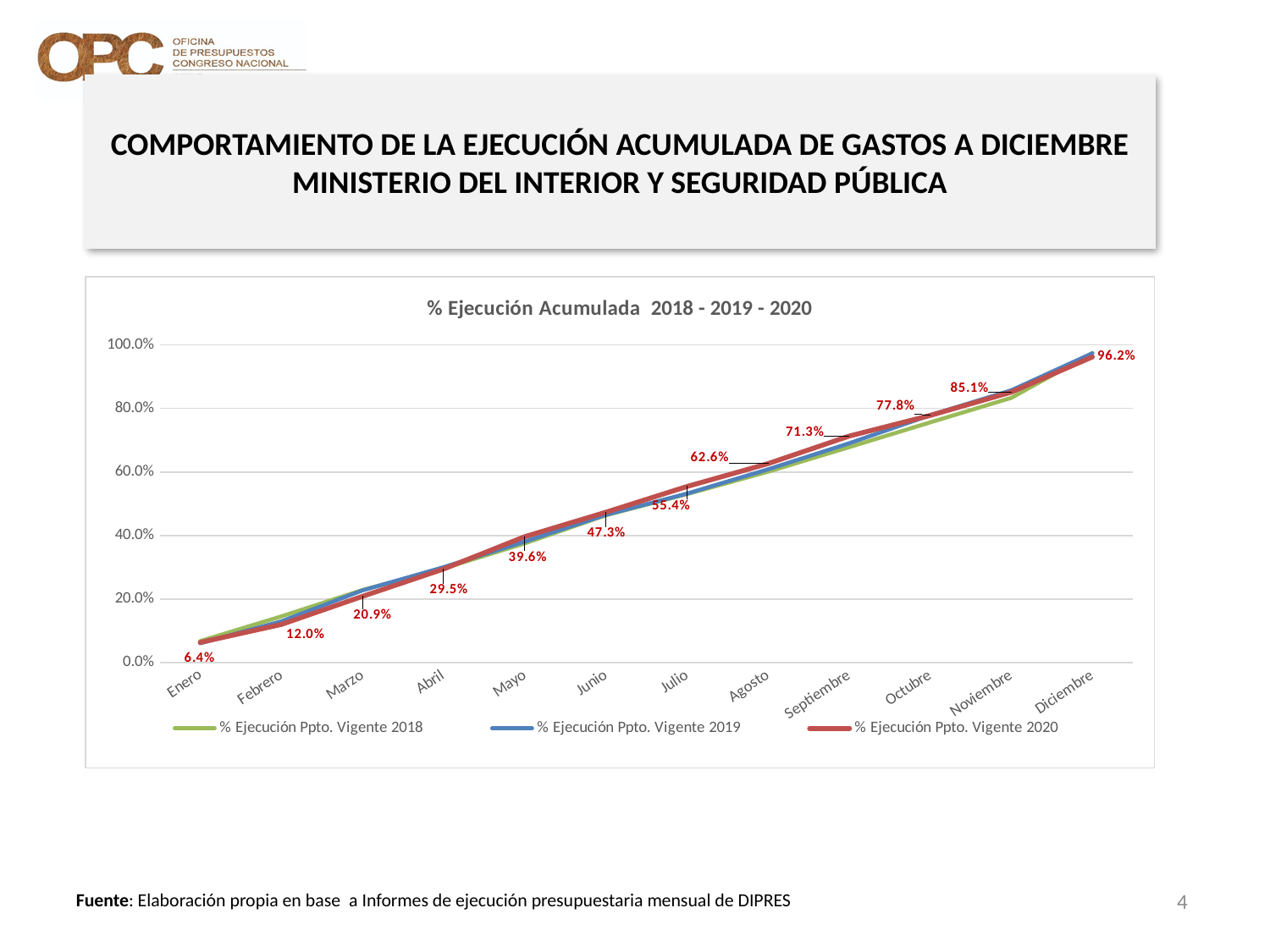
Which month has the highest value in the % Ejecución Ppto. Vigente 2020 series? Diciembre Is the value for Julio in the % Ejecución Ppto. Vigente 2018 series greater or less than 60.0%? less What is the value for Enero in the % Ejecución Ppto. Vigente 2020 series? 6.4% What is the difference between the Diciembre and Noviembre values in the % Ejecución Ppto. Vigente 2020 series? 11.1% What is the value for Octubre in the % Ejecución Ppto. Vigente 2020 series? 77.8% Which month has the lowest value in the % Ejecución Ppto. Vigente 2020 series? Enero What is the value for Diciembre in the % Ejecución Ppto. Vigente 2020 series? 96.2% How many series does the legend of the chart list? 3 What kind of chart is shown on the slide? Line chart What is the value for Junio in the % Ejecución Ppto. Vigente 2020 series? 47.3% How many months are plotted on the x axis of the chart? 12 In the % Ejecución Ppto. Vigente 2020 series, which is larger, the value for Agosto or the value for Julio? Agosto